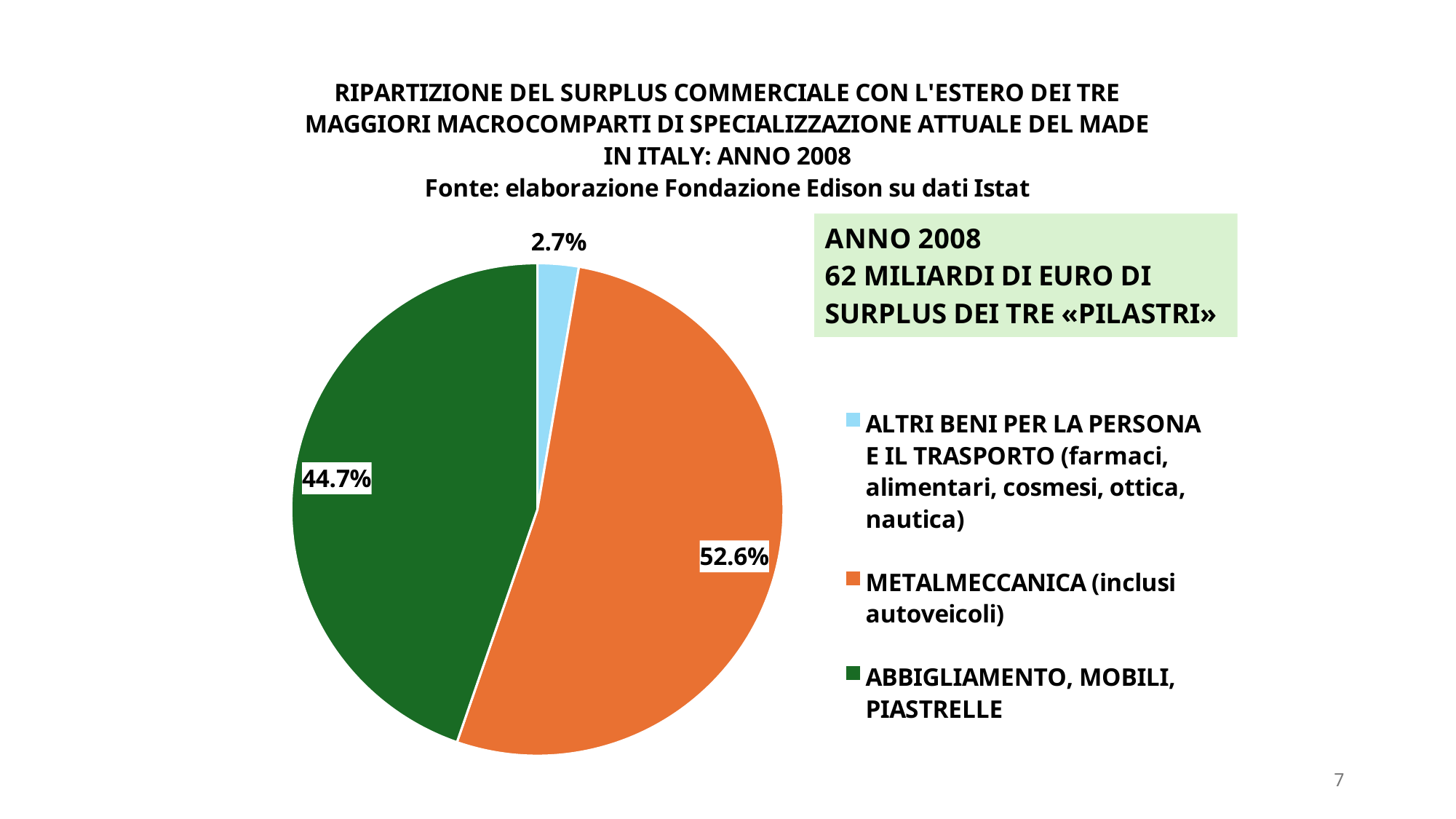
What is the difference in percentage points between the METALMECCANICA share and the ABBIGLIAMENTO, MOBILI, PIASTRELLE share? 7.9 percentage points What kind of chart is shown on the slide? Pie chart What share of the surplus does ALTRI BENI PER LA PERSONA E IL TRASPORTO account for? 2.7% What share of the surplus does ABBIGLIAMENTO, MOBILI, PIASTRELLE account for? 44.7% How many slices does the pie chart have? 3 What colour is the slice for ABBIGLIAMENTO, MOBILI, PIASTRELLE? Green What share of the surplus does METALMECCANICA (inclusi autoveicoli) account for? 52.6% Which category has the smallest share of the pie? ALTRI BENI PER LA PERSONA E IL TRASPORTO (farmaci, alimentari, cosmesi, ottica, nautica) Which category has the largest share of the pie? METALMECCANICA (inclusi autoveicoli) How many entries does the legend list? 3 Which is larger: the share for ABBIGLIAMENTO, MOBILI, PIASTRELLE or the share for METALMECCANICA (inclusi autoveicoli)? METALMECCANICA (inclusi autoveicoli) According to the slide, what is the total surplus of the three 'pilastri' in 2008? 62 miliardi di euro